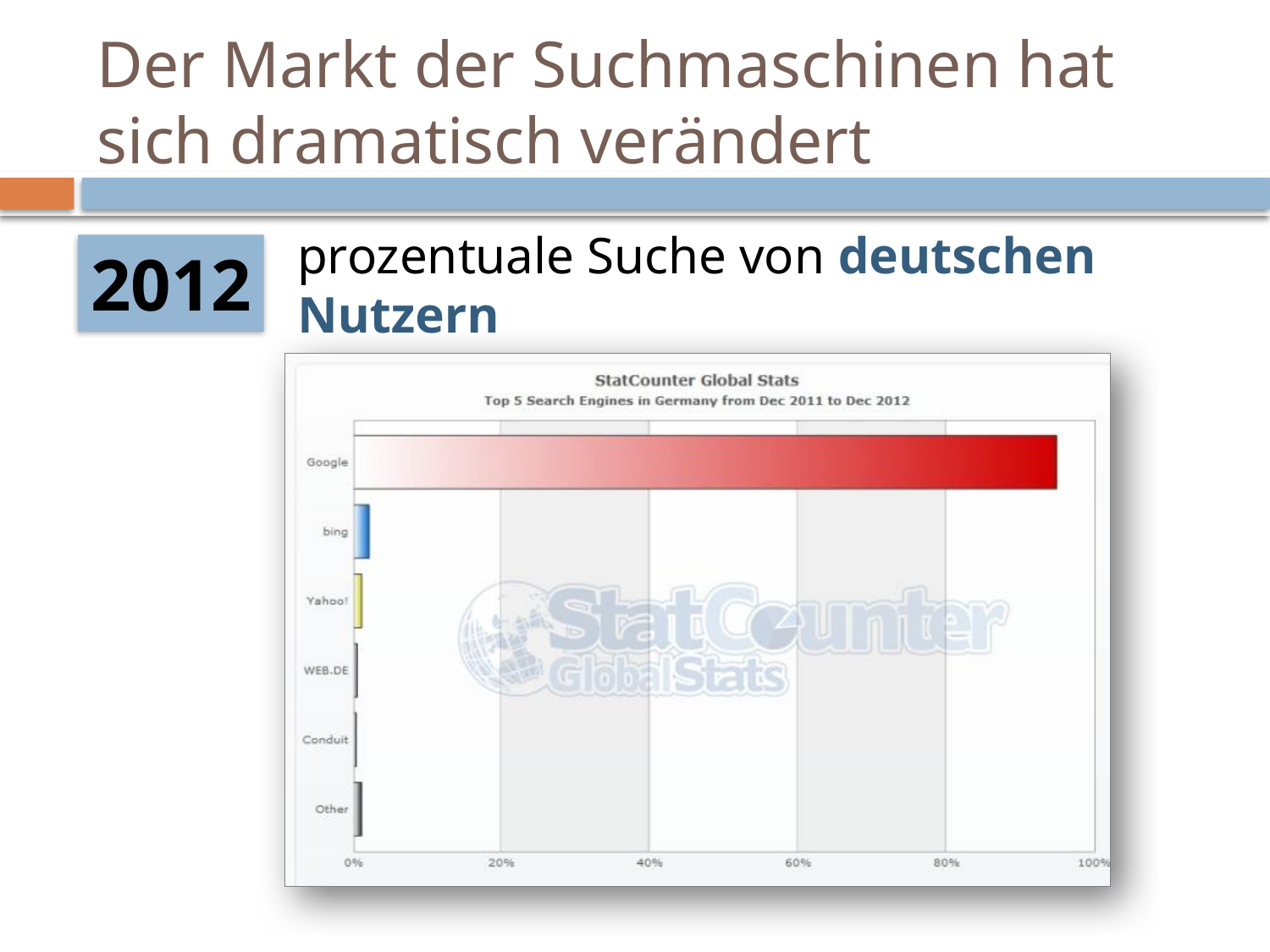
Which search engine has the highest share in the chart? Google Which category is listed last (at the bottom) of the chart? Other Is the value for Yahoo! greater or less than 20%? less Is the value for bing greater or less than 20%? less Which has a larger value, Yahoo! or Google? Google What is the highest value shown on the x axis of the chart? 100% Is the value for Google greater or less than 80%? greater What kind of chart is shown on the slide? bar chart Which has a larger value, Google or bing? Google How many search engine categories are listed on the chart? 6 What is the subtitle of the chart describing the data? Top 5 Search Engines in Germany from Dec 2011 to Dec 2012